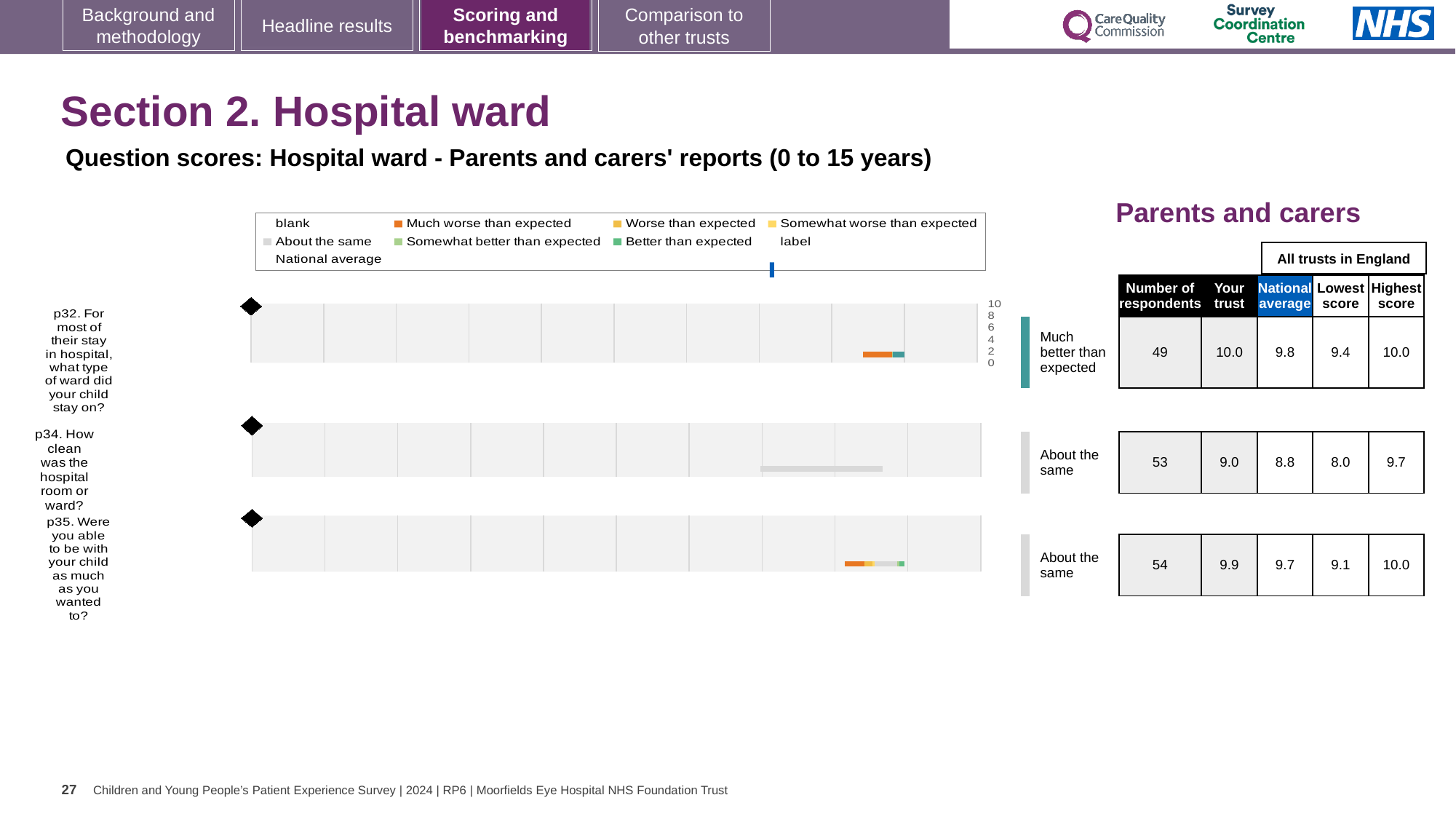
What is the national average score for p34 (How clean was the hospital room or ward?)? 8.8 Is the 'Your trust' score for p34 greater or less than 8? greater What is the 'Your trust' score for p32 (For most of their stay in hospital, what type of ward did your child stay on?)? 10.0 For p35, which is larger: the 'Your trust' score or the national average? Your trust Which question has the highest 'Your trust' score? p32 Which question has the lowest 'Your trust' score? p34 What kind of chart is used to show the question scores on this slide? bar chart What is the lowest score among all trusts in England for p35 (Were you able to be with your child as much as you wanted to?)? 9.1 How many respondents are listed for p32 (what type of ward did your child stay on)? 49 What benchmark category is shown for p32 (what type of ward did your child stay on)? Much better than expected What is the difference between the highest score (9.7) and the lowest score (8.0) for p34? 1.7 How many questions (categories) are plotted in the Hospital ward question scores chart? 3